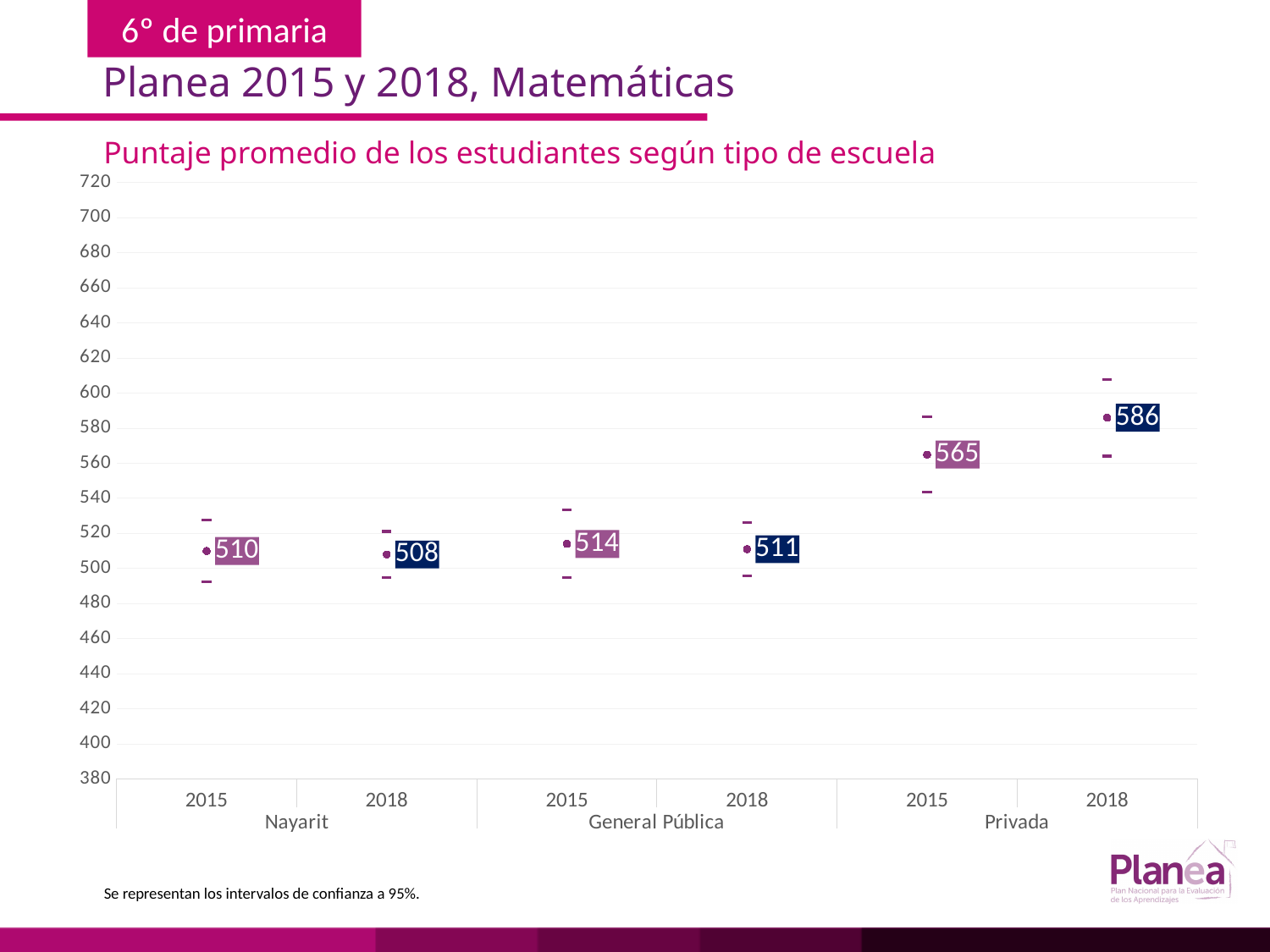
Which group and year has the lowest average score? Nayarit 2018 Did the Nayarit average score rise or fall from 2015 to 2018? fall What is the average score for General Pública in 2015? 514 What is the average score for Privada in 2018? 586 What is the average score for Nayarit in 2015? 510 What is the title of the chart? Puntaje promedio de los estudiantes según tipo de escuela Which is larger, the Privada score in 2015 or the General Pública score in 2018? Privada 2015 Is the value for Privada in 2015 greater or less than 540? greater Which group and year has the highest average score? Privada 2018 What is the difference between the Privada scores in 2018 and 2015? 21 What is the difference between the General Pública score in 2015 and the Nayarit score in 2015? 4